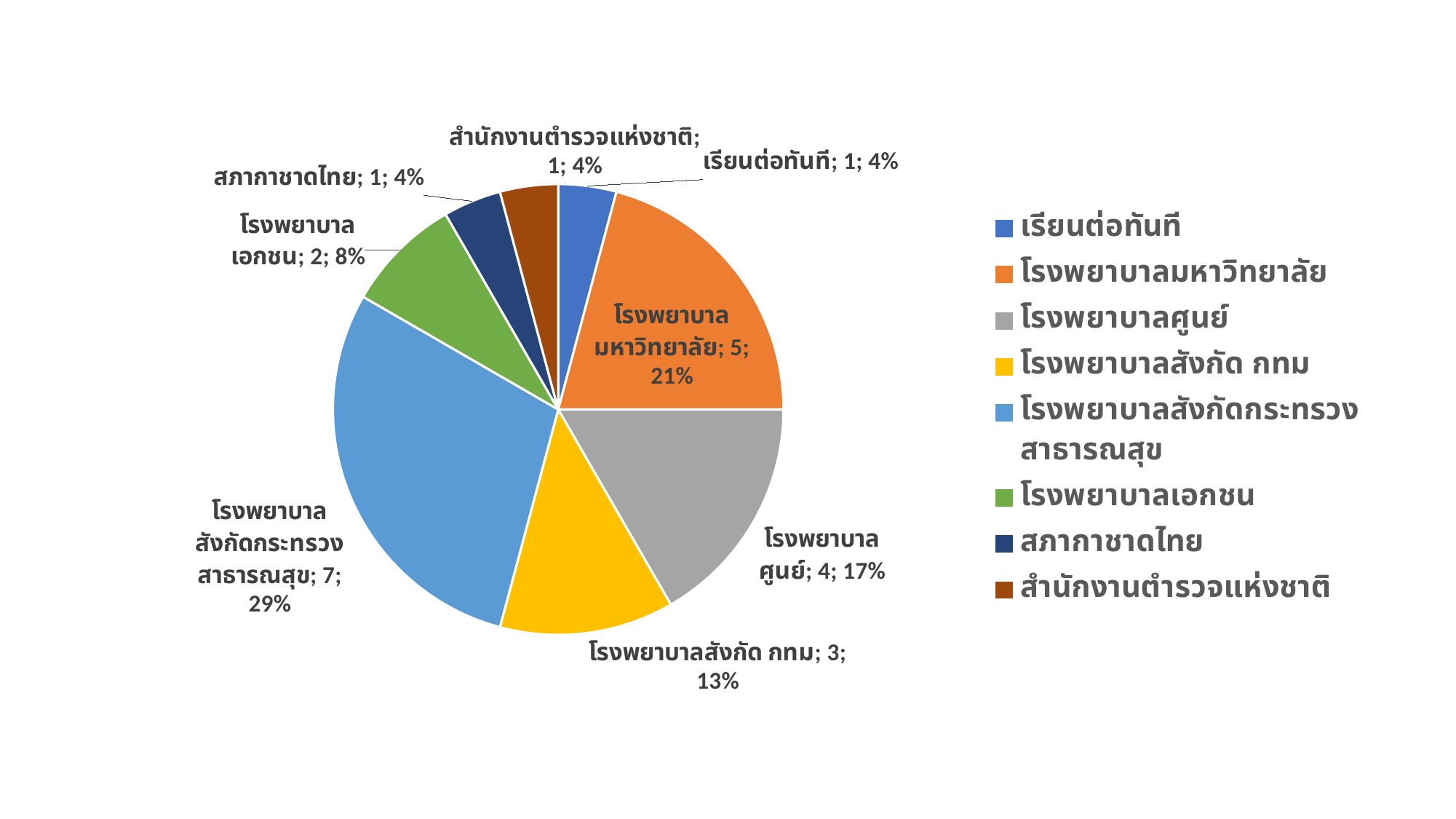
Which is larger, the value for โรงพยาบาลศูนย์ or the value for โรงพยาบาลเอกชน? โรงพยาบาลศูนย์ What colour is the slice for โรงพยาบาลสังกัด กทม? yellow Which category has the largest slice? โรงพยาบาลสังกัดกระทรวงสาธารณสุข What percentage share does โรงพยาบาลมหาวิทยาลัย have? 21% What is the value for โรงพยาบาลศูนย์? 4 What percentage share does โรงพยาบาลเอกชน have? 8% What kind of chart is shown on the slide? pie chart What is the value for สภากาชาดไทย? 1 What is the difference between the values for โรงพยาบาลสังกัดกระทรวงสาธารณสุข and โรงพยาบาลมหาวิทยาลัย? 2 How many categories (slices) does the pie chart have? 8 What is the value for โรงพยาบาลสังกัดกระทรวงสาธารณสุข? 7 What percentage share does โรงพยาบาลสังกัด กทม have? 13%